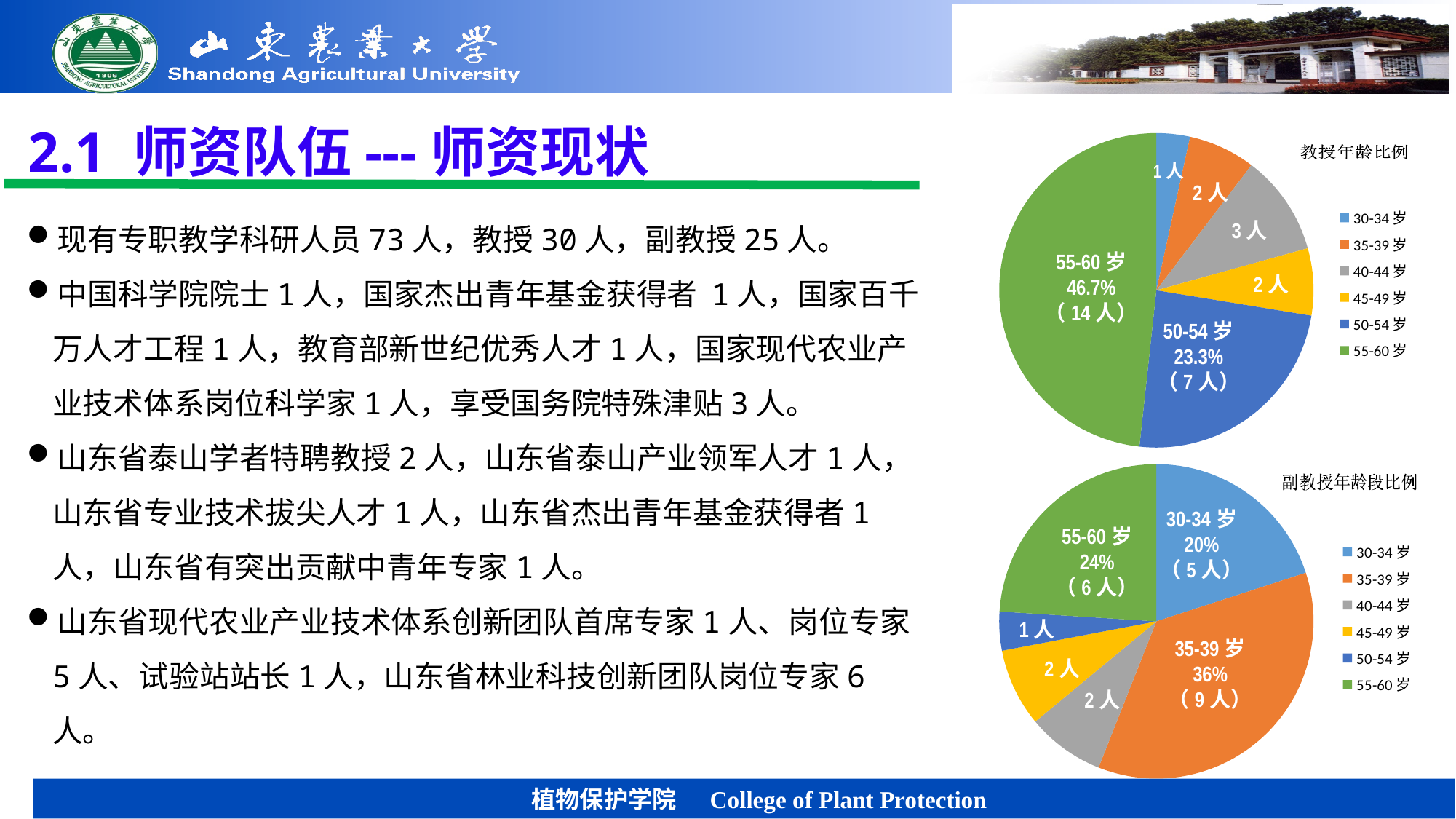
What kind of chart is the top chart titled 教授年龄比例? pie chart In the top chart (教授年龄比例), how many people are in the 55-60 岁 group? 14 人 In the top chart (教授年龄比例), which age group has the smallest slice? 30-34 岁 In the bottom chart (副教授年龄段比例), what colour is the 35-39 岁 slice? orange In the bottom chart (副教授年龄段比例), how many people are in the 35-39 岁 group? 9 人 In the bottom chart (副教授年龄段比例), what percentage share does the 55-60 岁 slice have? 24% In the top chart (教授年龄比例), how many more people are in the 55-60 岁 group than in the 50-54 岁 group? 7 人 How many entries does the legend of the top chart (教授年龄比例) list? 6 In the top chart (教授年龄比例), which age group has the largest slice? 55-60 岁 In the bottom chart (副教授年龄段比例), which age group has the smallest slice? 50-54 岁 In the bottom chart (副教授年龄段比例), which group is larger: 30-34 岁 or 55-60 岁? 55-60 岁 In the top chart (教授年龄比例), what percentage share does the 50-54 岁 slice have? 23.3%